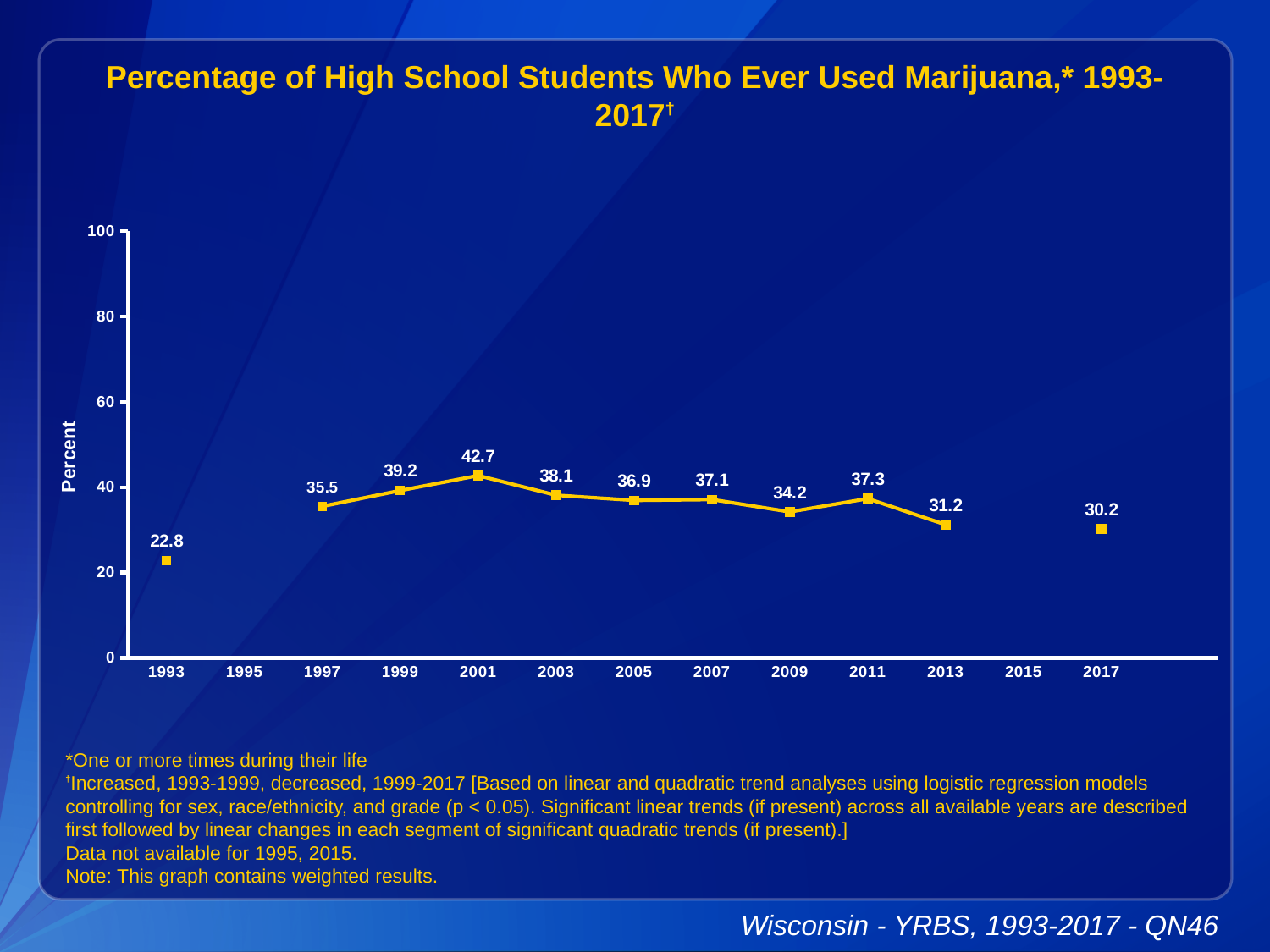
What is the label on the y axis? Percent What percentage of high school students had ever used marijuana in 2001? 42.7 What is the value plotted for 1993? 22.8 Which year has the lowest percentage of students who ever used marijuana? 1993 What is the value plotted for 2017? 30.2 Which year has the highest percentage of students who ever used marijuana? 2001 How many years have data points plotted on the chart? 11 Which year has a larger value, 2009 or 2011? 2011 What kind of chart is shown on the slide? line chart Is the value for 1999 greater or less than 40? less Did the values rise or fall from 2001 to 2013? fall What is the difference between the 2001 value and the 2013 value? 11.5